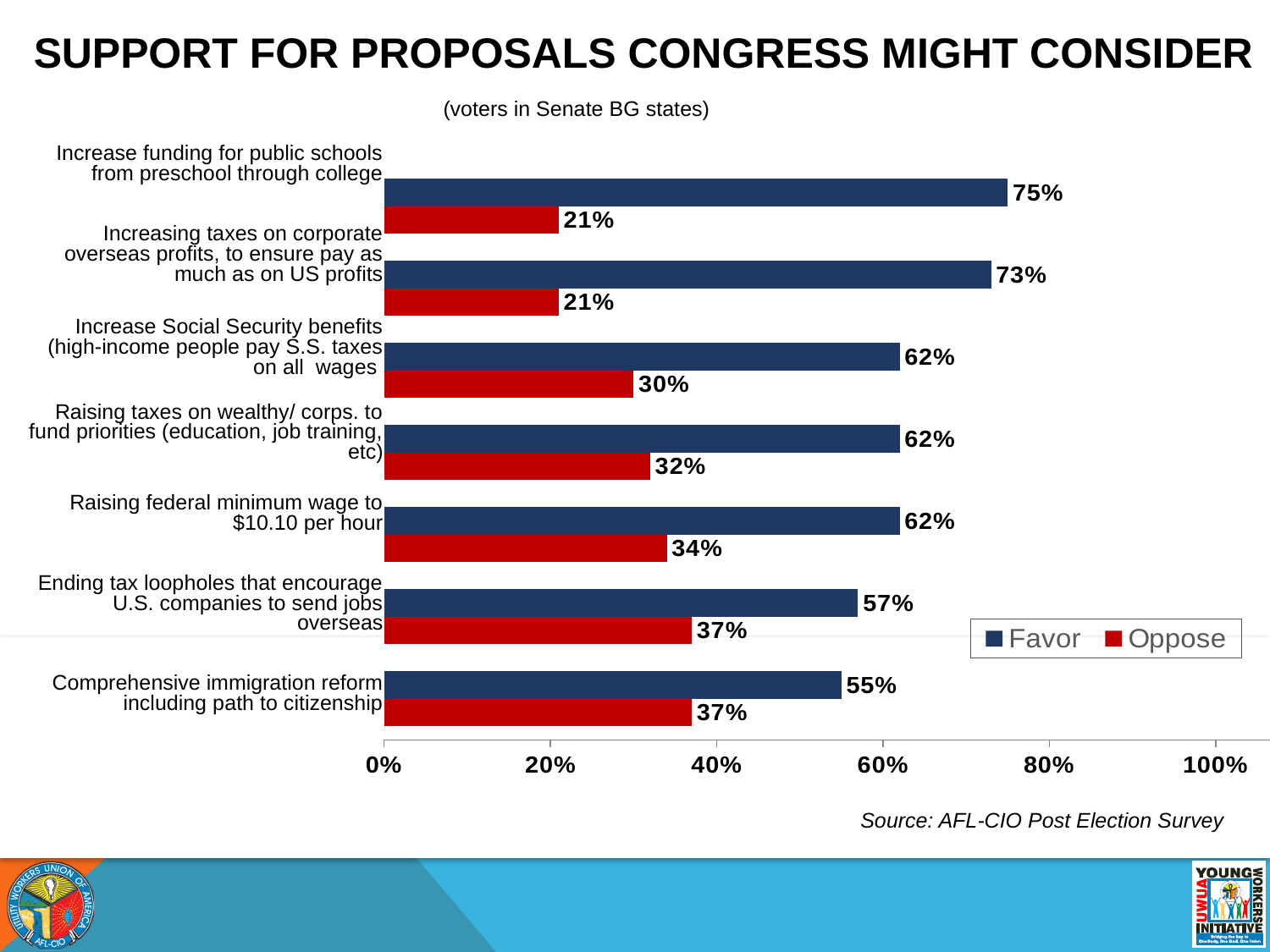
What percentage of voters favor increasing funding for public schools from preschool through college? 75% What is the difference between the Favor and Oppose percentages for ending tax loopholes that encourage U.S. companies to send jobs overseas? 20% Which is larger: the Oppose value for increasing Social Security benefits or the Oppose value for raising taxes on wealthy/corps. to fund priorities? Raising taxes on wealthy/ corps. to fund priorities What is the source cited for the chart data? AFL-CIO Post Election Survey How many proposals are shown in the chart? 7 Which proposal has the highest Favor percentage? Increase funding for public schools from preschool through college What percentage of voters oppose raising the federal minimum wage to $10.10 per hour? 34% What type of chart is shown on the slide? Bar chart Which proposal has the lowest Favor percentage? Comprehensive immigration reform including path to citizenship How many series does the legend list? 2 Is the Favor value for increasing taxes on corporate overseas profits greater or less than 60%? greater What is the Favor value for comprehensive immigration reform including path to citizenship? 55%